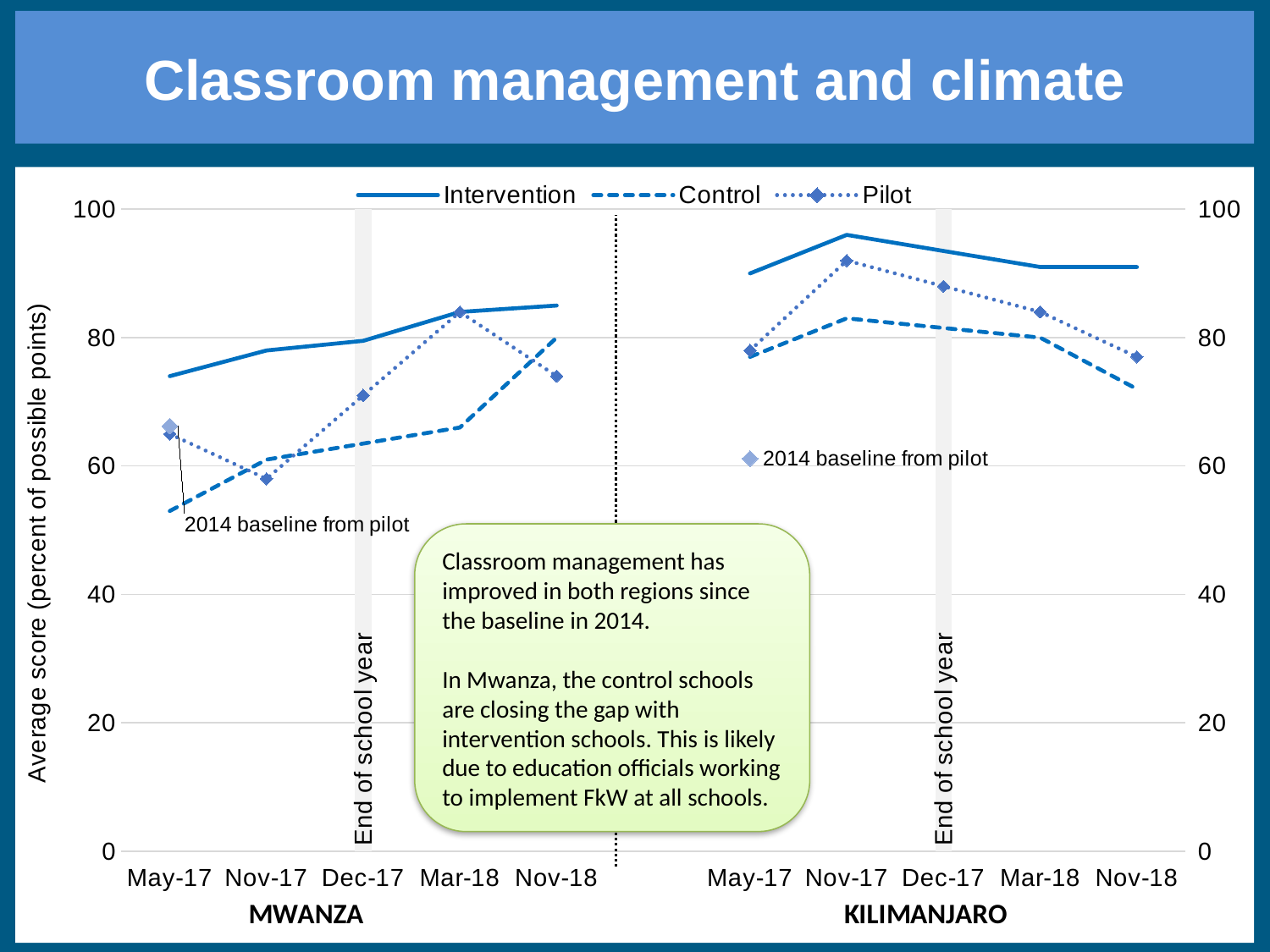
In the Kilimanjaro panel, is the Intervention value at Nov-17 greater or less than 80? greater What kind of chart is shown on the slide? line chart In the Mwanza panel, is the Intervention value at May-17 greater or less than 80? less In the Kilimanjaro panel, which is higher at Nov-17: Intervention or Control? Intervention In the Mwanza panel, is the Control value at May-17 greater or less than 60? less How many series does the legend list? 3 In the Mwanza panel, does the Intervention series rise or fall from May-17 to Nov-18? rise In the Kilimanjaro panel, at which time point does the Intervention series reach its highest value? Nov-17 What is the title of the slide? Classroom management and climate What is the label on the vertical axis? Average score (percent of possible points) How many time points are plotted on the x axis for the Mwanza panel? 5